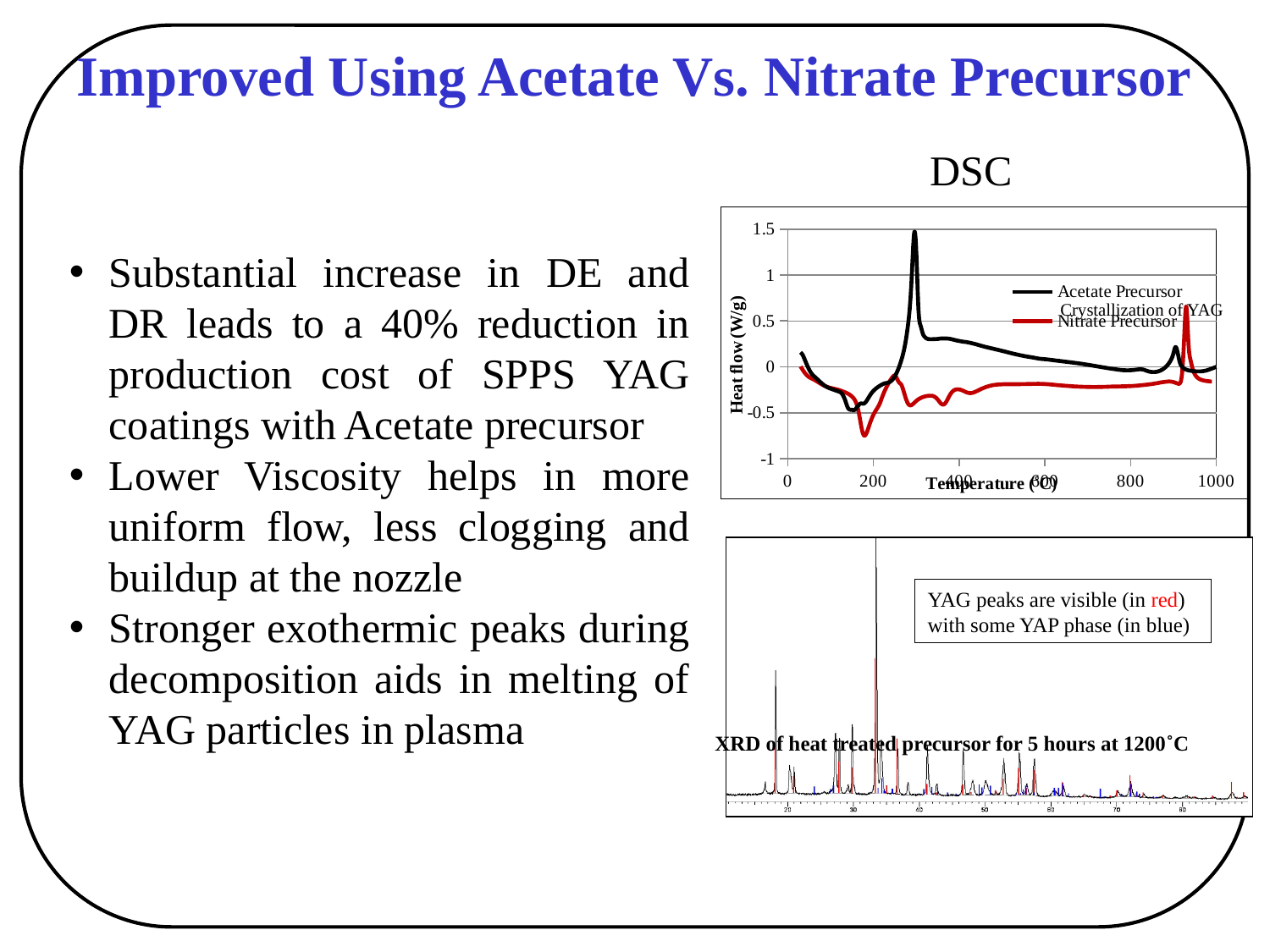
What kind of chart is the DSC chart on the slide? line chart How many series does the legend of the DSC chart list? 2 How many tick labels are shown on the x axis of the DSC chart? 6 What is the title of the y axis of the DSC chart? Heat flow (W/g) In the DSC chart, which series reaches the lowest heat flow value? Nitrate Precursor In the DSC chart, is the peak of the Acetate Precursor near 900 °C greater or less than 0.5 W/g? less In the DSC chart, which series reaches the highest heat flow value? Acetate Precursor In the DSC chart, which series has the larger peak near 300 °C, Acetate Precursor or Nitrate Precursor? Acetate Precursor In the DSC chart, is the lowest heat flow of the Nitrate Precursor greater or less than -0.5 W/g? less What is the maximum temperature shown on the x axis of the DSC chart? 1000 In the DSC chart, is the peak heat flow of the Acetate Precursor greater or less than 1 W/g? greater What colour is the Nitrate Precursor line in the DSC chart? red